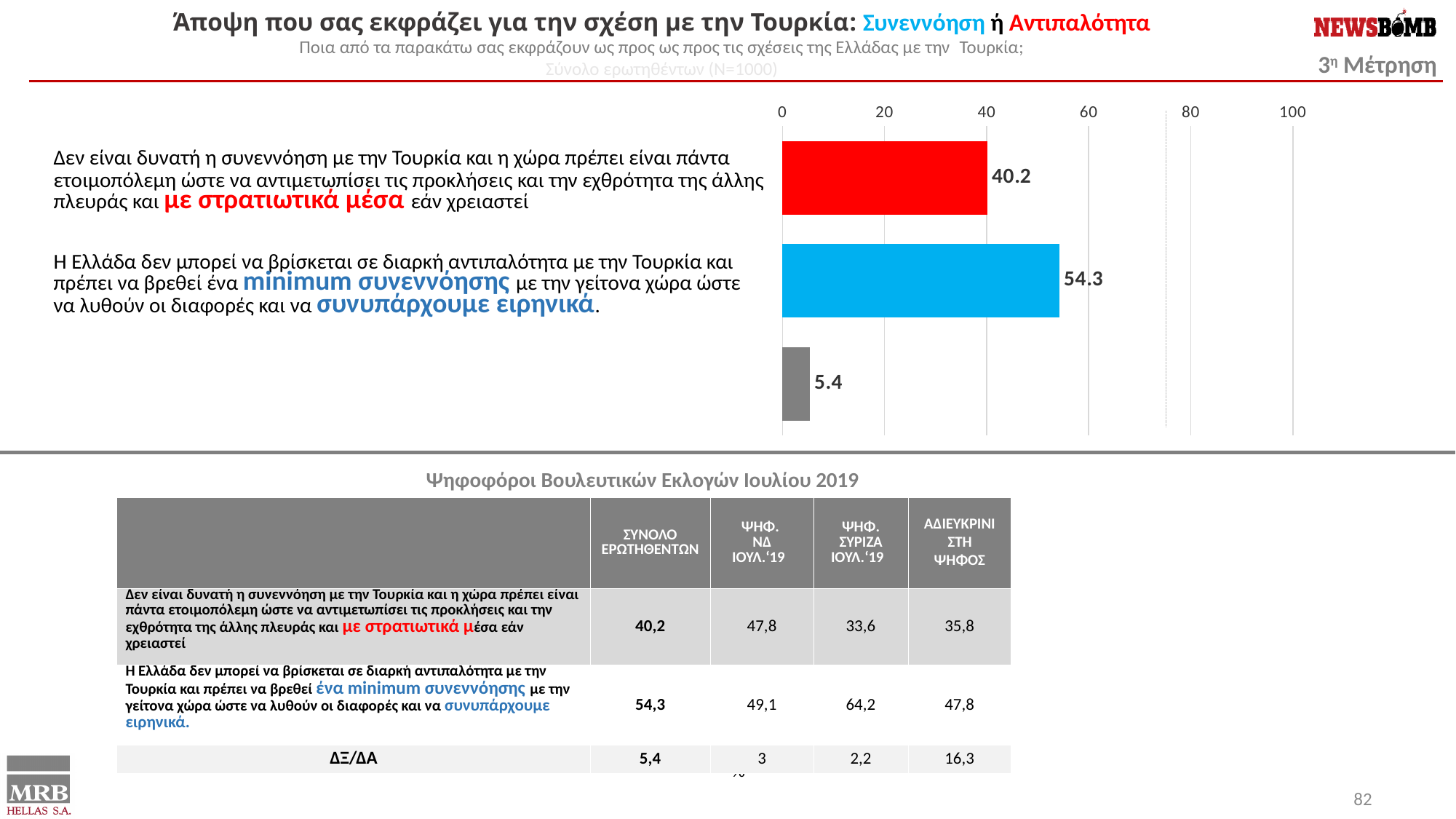
What is the maximum value shown on the chart's axis? 100 Is the value of the red bar greater or less than 40? greater What is the value of the blue bar (the option about finding a minimum understanding and coexisting peacefully with Turkey)? 54.3 Which bar has the lowest value in the chart? The grey bar (5.4) What is the difference between the blue bar (54.3) and the red bar (40.2)? 14.1 What type of chart is shown on the slide? Bar chart How many bars are plotted in the chart? 3 What colour is the bar representing the option about a minimum understanding with Turkey? Blue What is the value of the grey bar at the bottom of the chart? 5.4 Which option has the highest value in the chart? Finding a minimum understanding and coexisting peacefully with Turkey (54.3) What is the value of the red bar (the option about confronting Turkey with military means if needed)? 40.2 Which is larger: the value for the military-means option or the value for the minimum-understanding option? The minimum-understanding option (54.3)